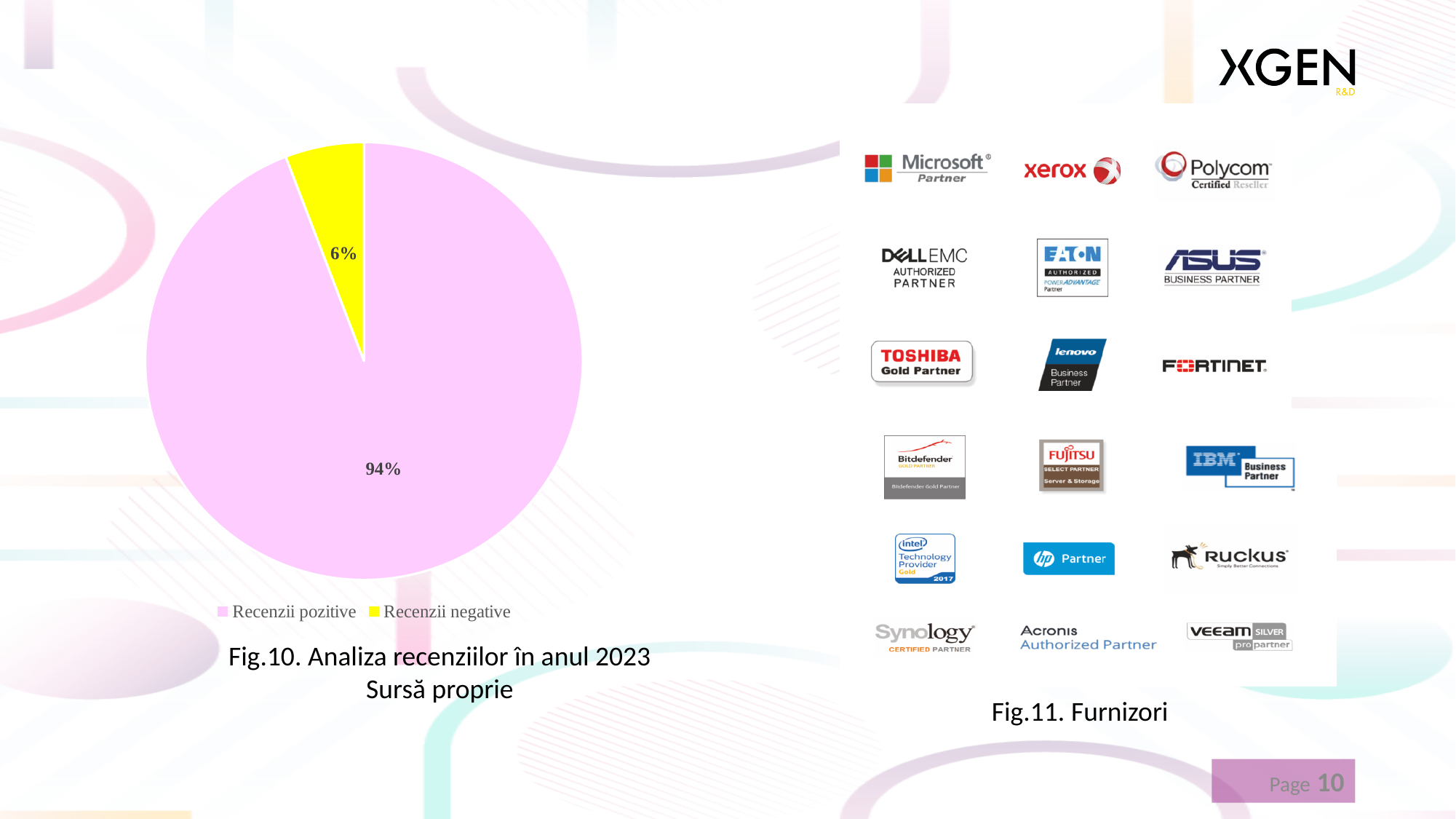
What share of the pie is labelled Recenzii pozitive? 94% Which slice of the pie is the largest? Recenzii pozitive Which slice of the pie is the smallest? Recenzii negative How many entries does the legend list? 2 How many slices does the pie chart have? 2 Which is larger, Recenzii pozitive or Recenzii negative? Recenzii pozitive What share of the pie is labelled Recenzii negative? 6% What colour is the Recenzii negative slice? yellow What is the difference in percentage points between Recenzii pozitive and Recenzii negative? 88 What kind of chart is shown on the slide? pie chart What is the caption of the pie chart figure? Fig.10. Analiza recenziilor în anul 2023